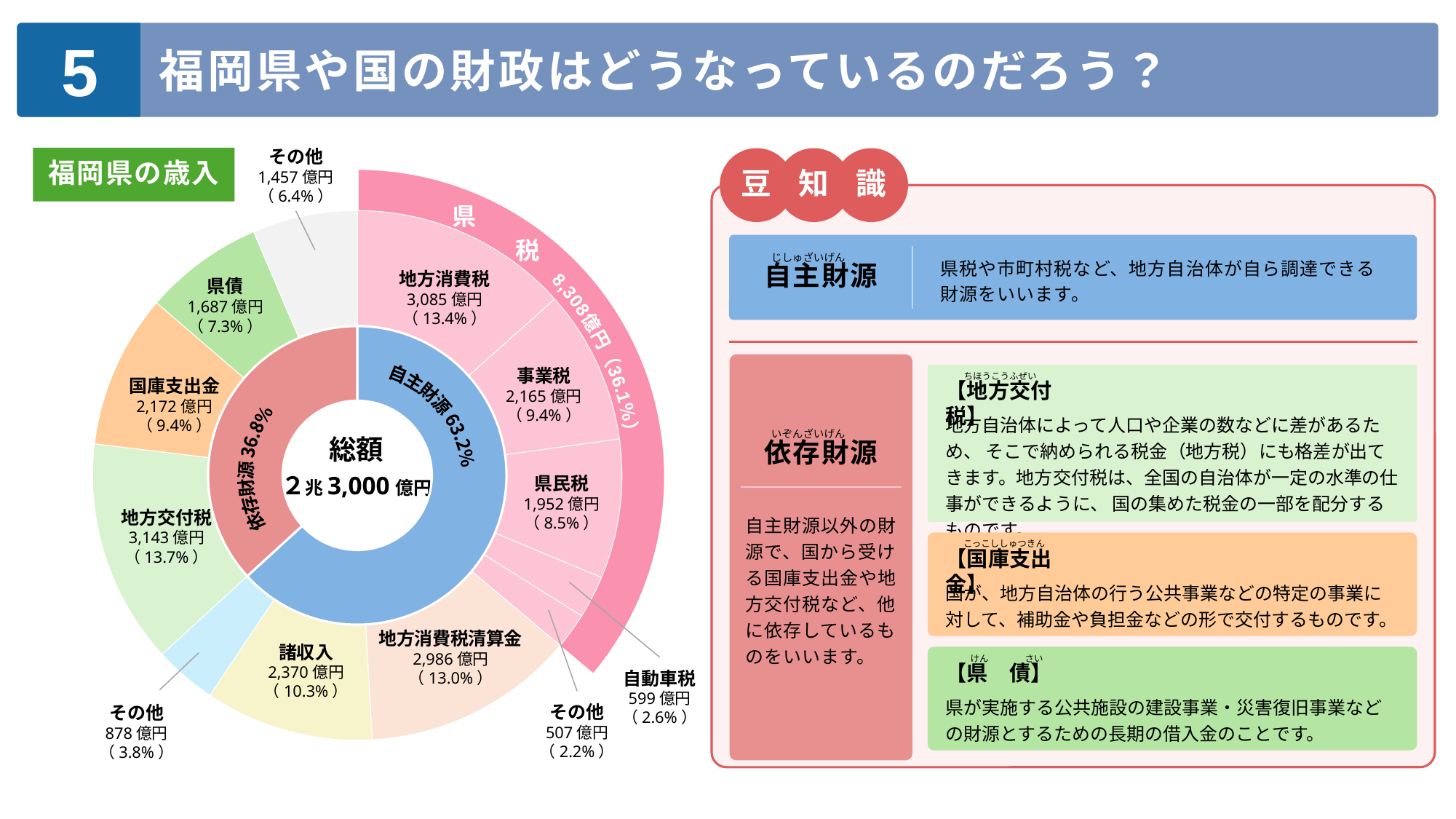
Which of the 県税 sub-items in the 福岡県の歳入 chart is the smallest? その他 (507億円) What is the value of 県債 in the 福岡県の歳入 chart? 1,687億円 What is the value of 地方交付税 in the 福岡県の歳入 chart? 3,143億円 Which is larger in the 福岡県の歳入 chart, 事業税 or 県民税? 事業税 What kind of chart is used to show 福岡県の歳入? Doughnut (pie) chart What is the difference between 地方交付税 and 国庫支出金 in the 福岡県の歳入 chart? 971億円 What is the total amount (総額) shown in the centre of the 福岡県の歳入 chart? 2兆3,000億円 What share of 福岡県の歳入 does 地方消費税 represent? 13.4% What percentage of 福岡県の歳入 is 依存財源 according to the inner ring? 36.8% What is the value of 県税 in the 福岡県の歳入 chart? 8,308億円 What is the value of 自動車税 in the 福岡県の歳入 chart? 599億円 What percentage of 福岡県の歳入 is 自主財源 according to the inner ring? 63.2%